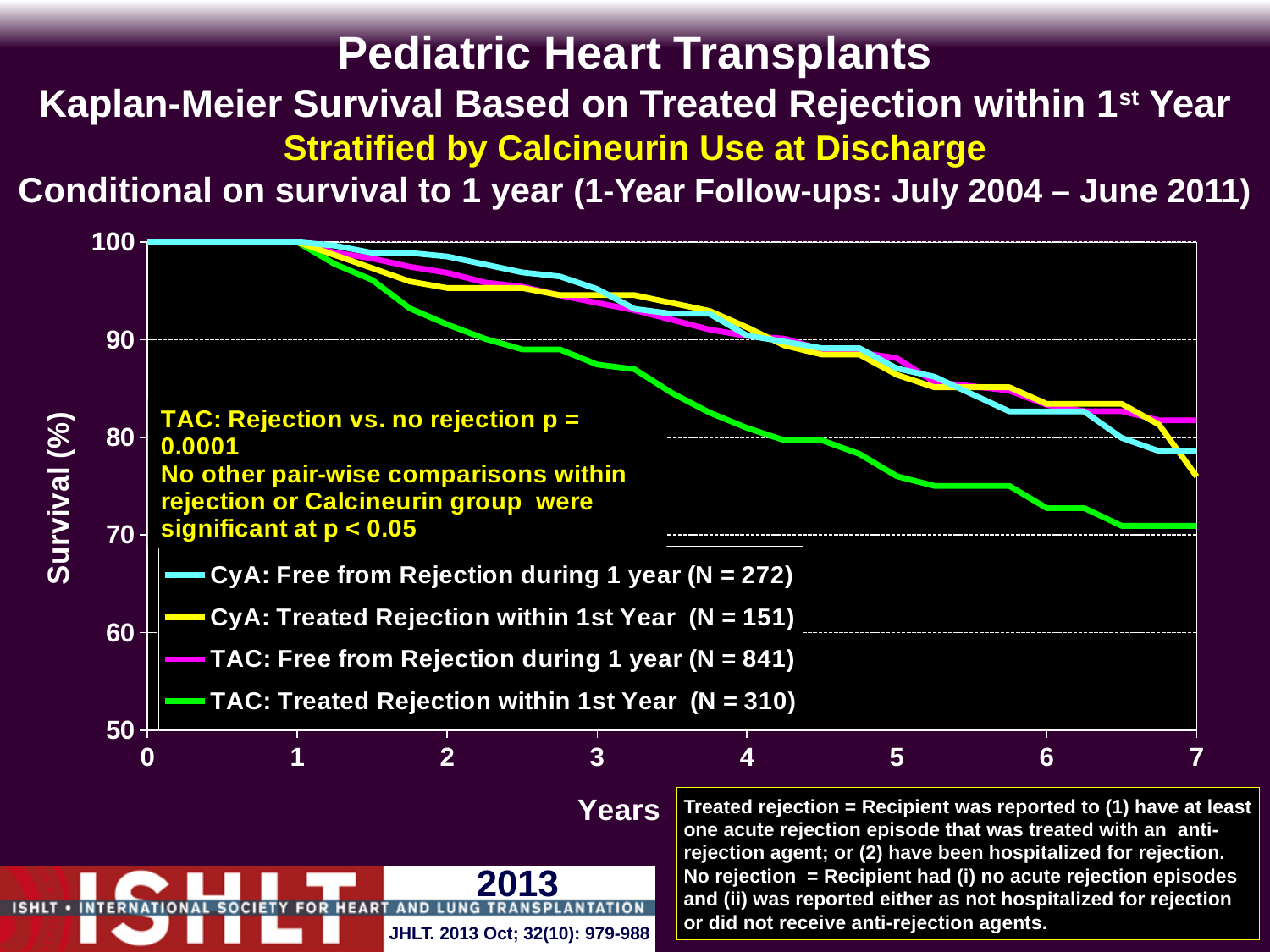
What kind of chart is shown on the slide? line chart Which series has the lowest survival at 7 years? TAC: Treated Rejection within 1st Year At 7 years, which is higher: CyA: Free from Rejection during 1 year or TAC: Treated Rejection within 1st Year? CyA: Free from Rejection during 1 year What is the N for the CyA: Treated Rejection within 1st Year series? 151 What is the N for the TAC: Free from Rejection during 1 year series? 841 What p-value is given for TAC rejection vs. no rejection? 0.0001 Is the survival for TAC: Treated Rejection within 1st Year at 7 years greater or less than 80? less How many series does the legend list? 4 What is the N for the CyA: Free from Rejection during 1 year series? 272 Do the survival curves rise or fall as years increase? fall What is the N for the TAC: Treated Rejection within 1st Year series? 310